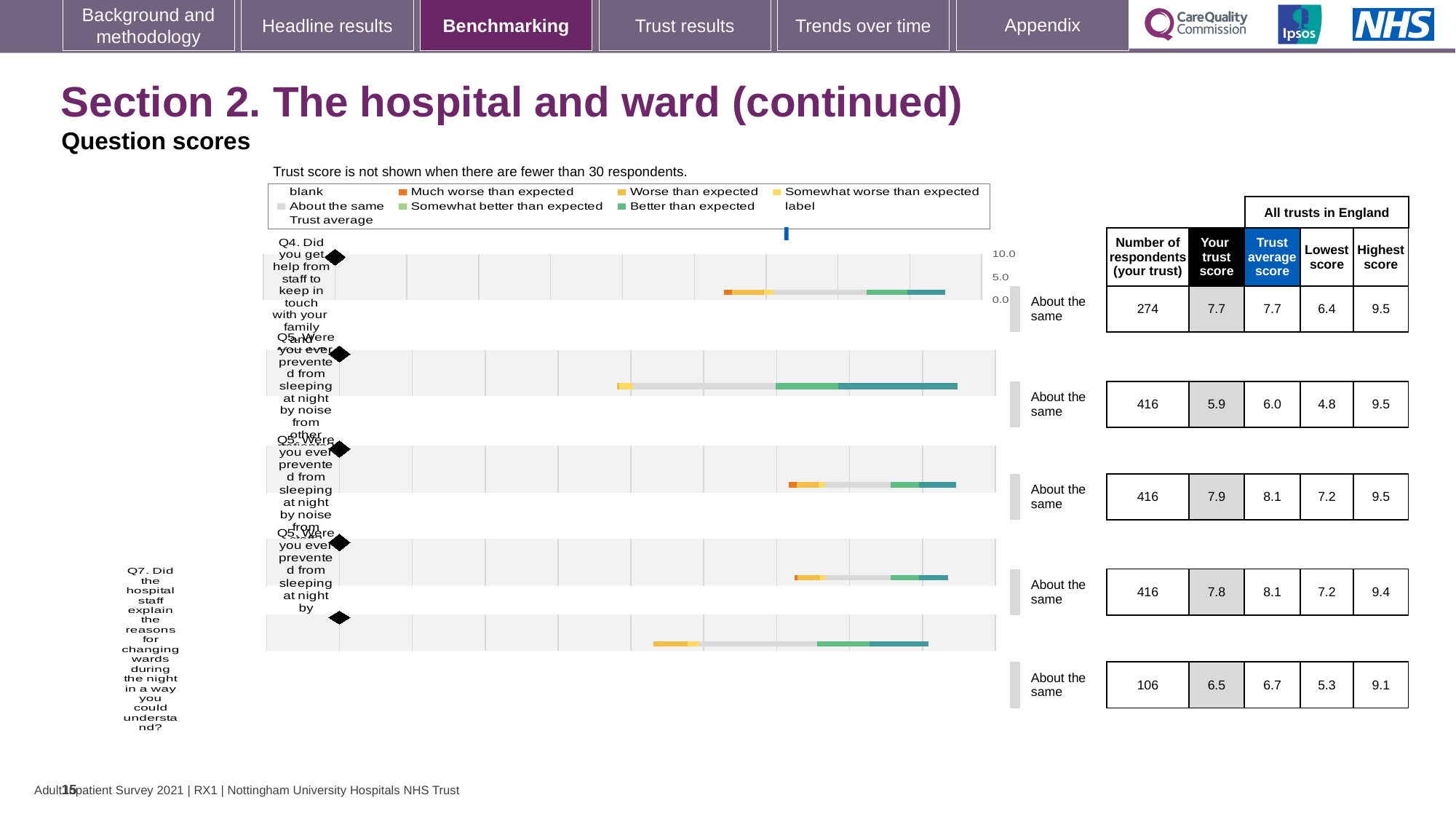
What is your trust score for Q4 (help from staff to keep in touch with family and friends)? 7.7 What is your trust score for Q7 (staff explaining reasons for changing wards during the night)? 6.5 What is the difference between the highest score and the lowest score for Q7? 3.8 What is the highest score across all trusts in England for Q4? 9.5 Is your trust score for Q4 greater or less than 5.0? greater What is the trust average score for Q7 (staff explaining reasons for changing wards during the night)? 6.7 Which has the larger 'Your trust score', Q4 or Q7? Q4 Which question row has the lowest number of respondents? Q7 How many respondents from your trust answered Q4 (help from staff to keep in touch with family and friends)? 274 What benchmark category label is shown next to every question row in the chart? About the same What kind of chart is shown on the slide? bar chart How many question rows (bars) are plotted in the chart? 5